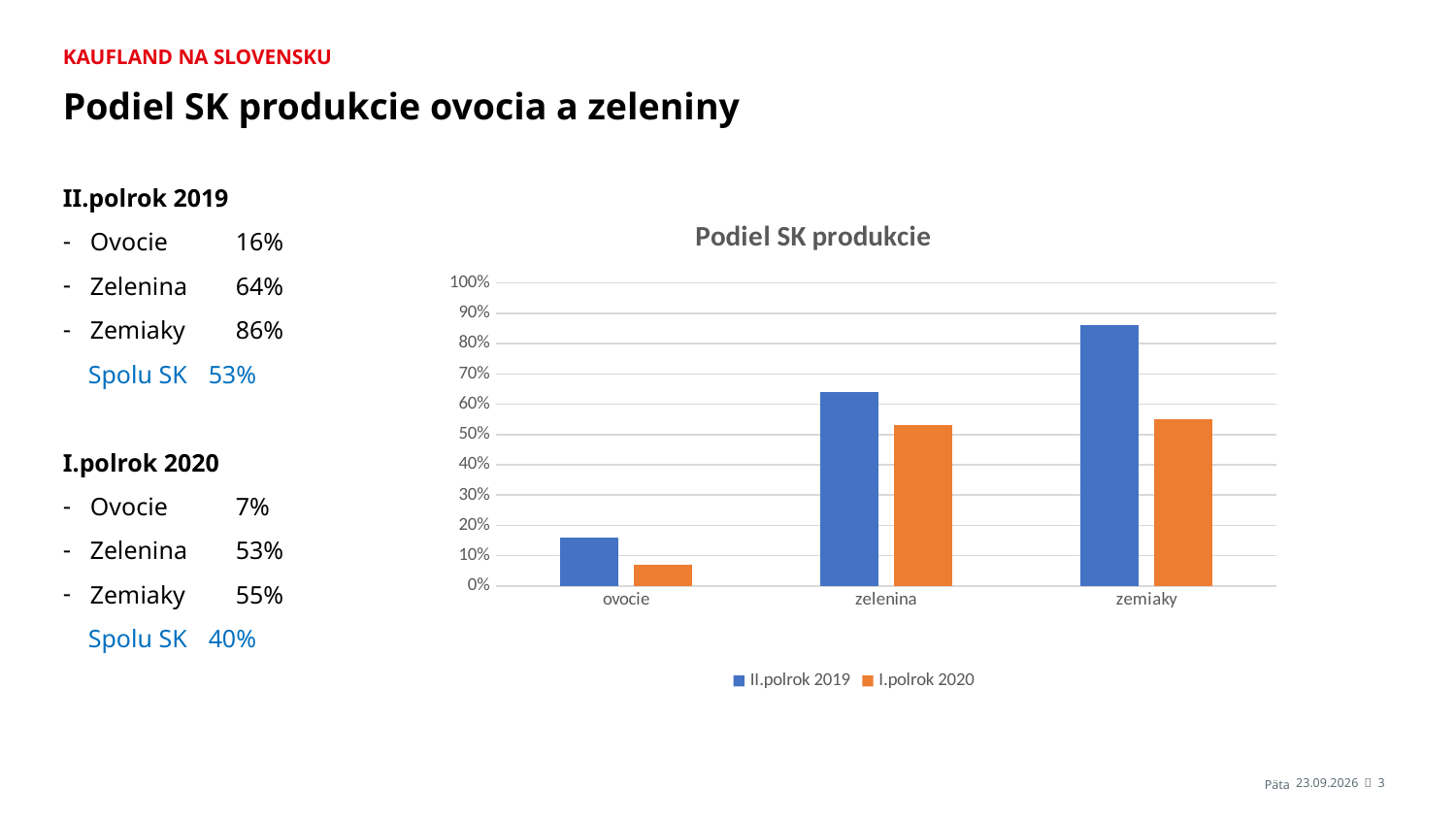
What is the difference between the zemiaky values for II.polrok 2019 and I.polrok 2020? 31% What is the value for ovocie in I.polrok 2020? 7% Is the value for zelenina in II.polrok 2019 greater or less than 60%? greater Which is larger for zemiaky: the II.polrok 2019 value or the I.polrok 2020 value? II.polrok 2019 Which category has the lowest value for I.polrok 2020? ovocie Is the value for ovocie in II.polrok 2019 greater or less than 20%? less What kind of chart is shown on the slide? bar chart What is the value for zemiaky in II.polrok 2019? 86% How many categories are shown on the x axis of the chart? 3 How many series does the chart legend list? 2 Which category has the highest value for II.polrok 2019? zemiaky What is the title of the chart? Podiel SK produkcie